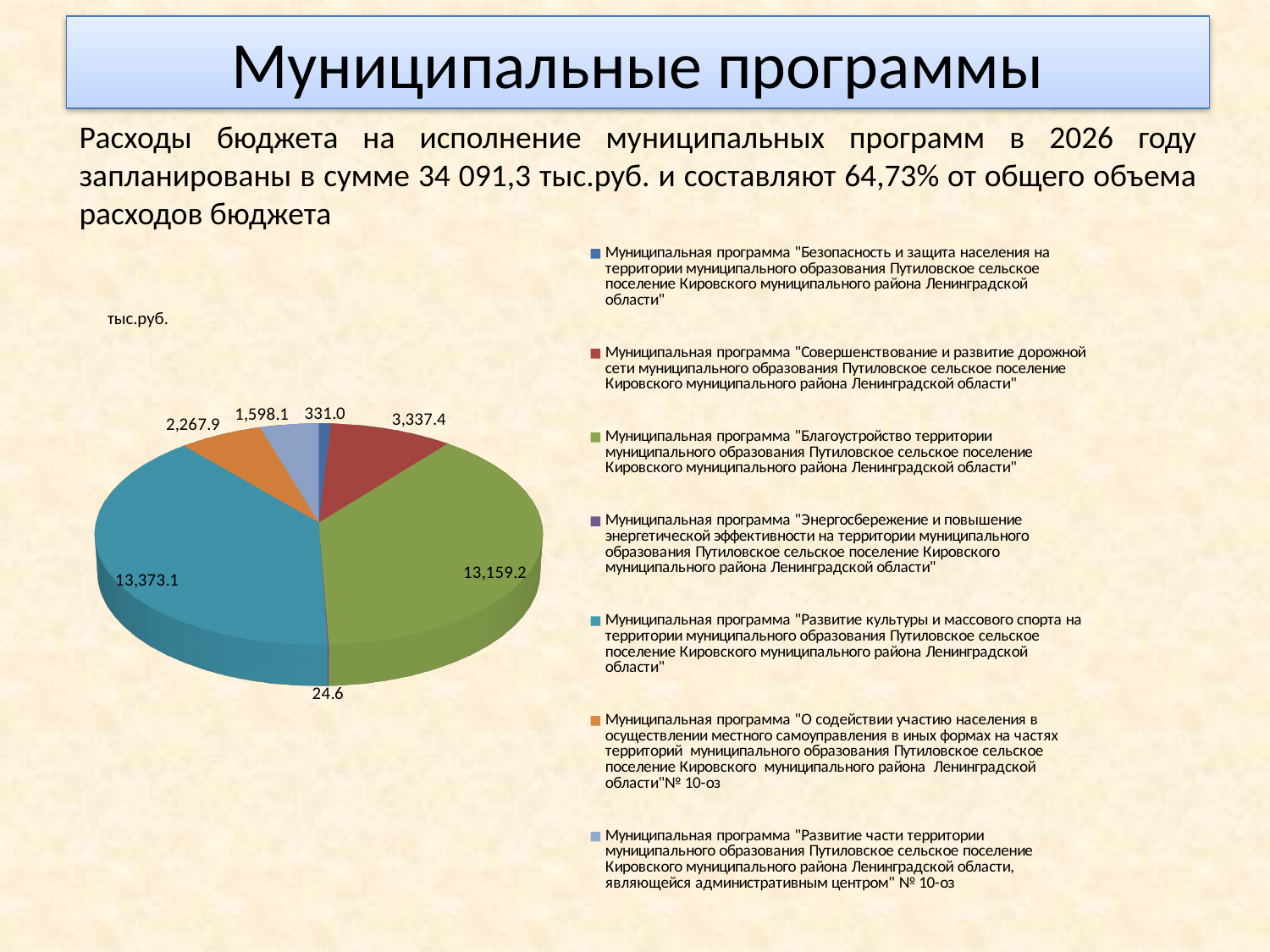
What is the value for the municipal program "Энергосбережение и повышение энергетической эффективности" in the pie chart? 24.6 Which municipal program has the smallest slice in the pie chart? Энергосбережение и повышение энергетической эффективности What kind of chart is shown on the slide? pie chart Which is larger in the pie chart: the value for "Совершенствование и развитие дорожной сети" or the value for "О содействии участию населения"? Совершенствование и развитие дорожной сети How many slices does the pie chart have? 7 What unit is indicated for the values in the pie chart? тыс.руб. What is the value for the municipal program "Совершенствование и развитие дорожной сети" in the pie chart? 3,337.4 What is the difference between the values for "Совершенствование и развитие дорожной сети" (3,337.4) and "О содействии участию населения" (2,267.9) in the pie chart? 1,069.5 Which municipal program has the largest slice in the pie chart? Развитие культуры и массового спорта What is the value for the municipal program "Благоустройство территории" in the pie chart? 13,159.2 How many entries does the legend of the pie chart list? 7 What is the value for the municipal program "Развитие культуры и массового спорта" in the pie chart? 13,373.1